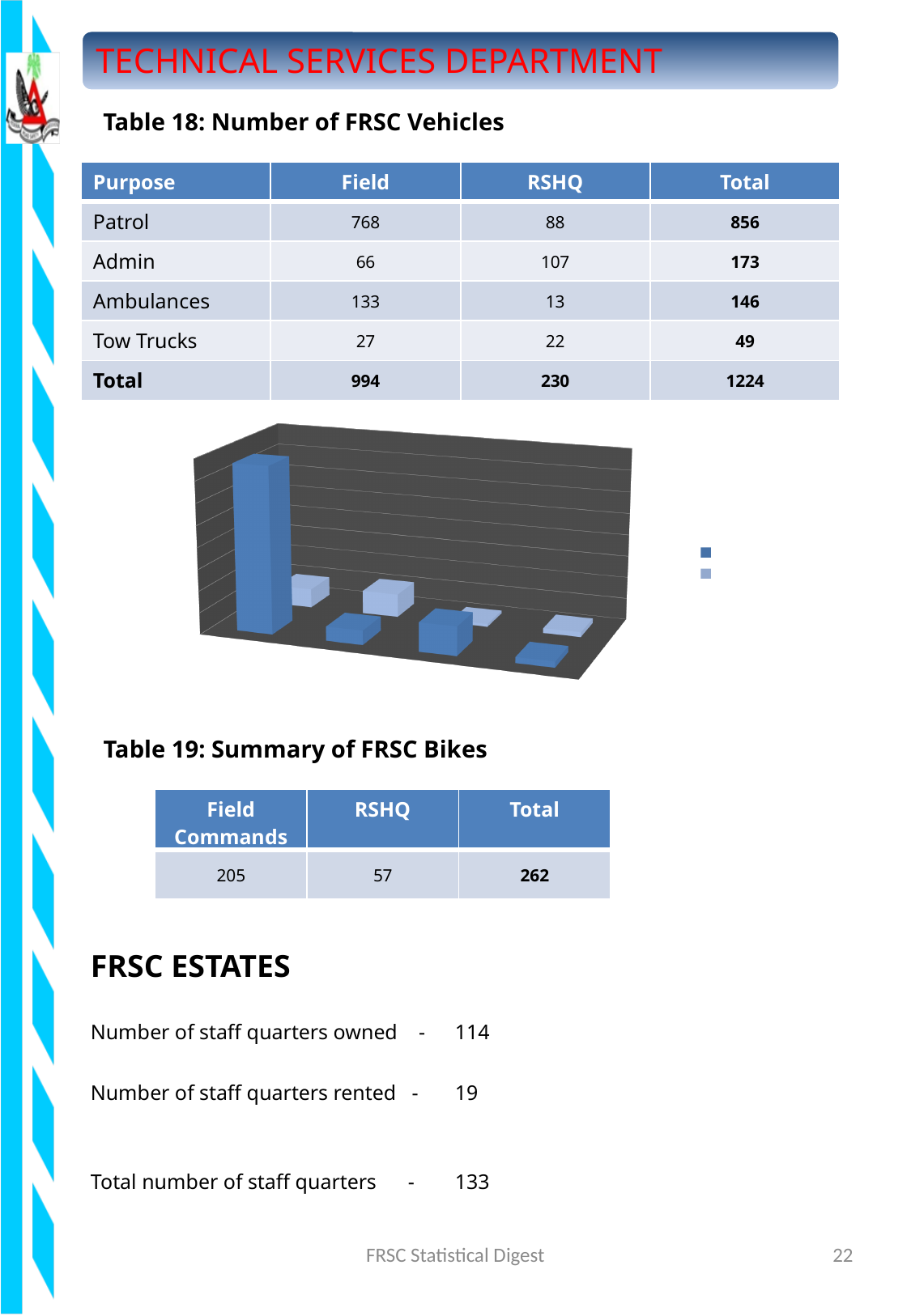
What two colours are used for the bars in the chart? dark blue and light blue How many series does the chart's legend list? 2 Does the chart display any data labels on its bars? No How many categories (groups of bars) are plotted in the chart? 4 What kind of chart is shown on the slide? bar chart In the chart, which bar is the tallest: the leftmost dark blue bar or the leftmost light blue bar? the leftmost dark blue bar